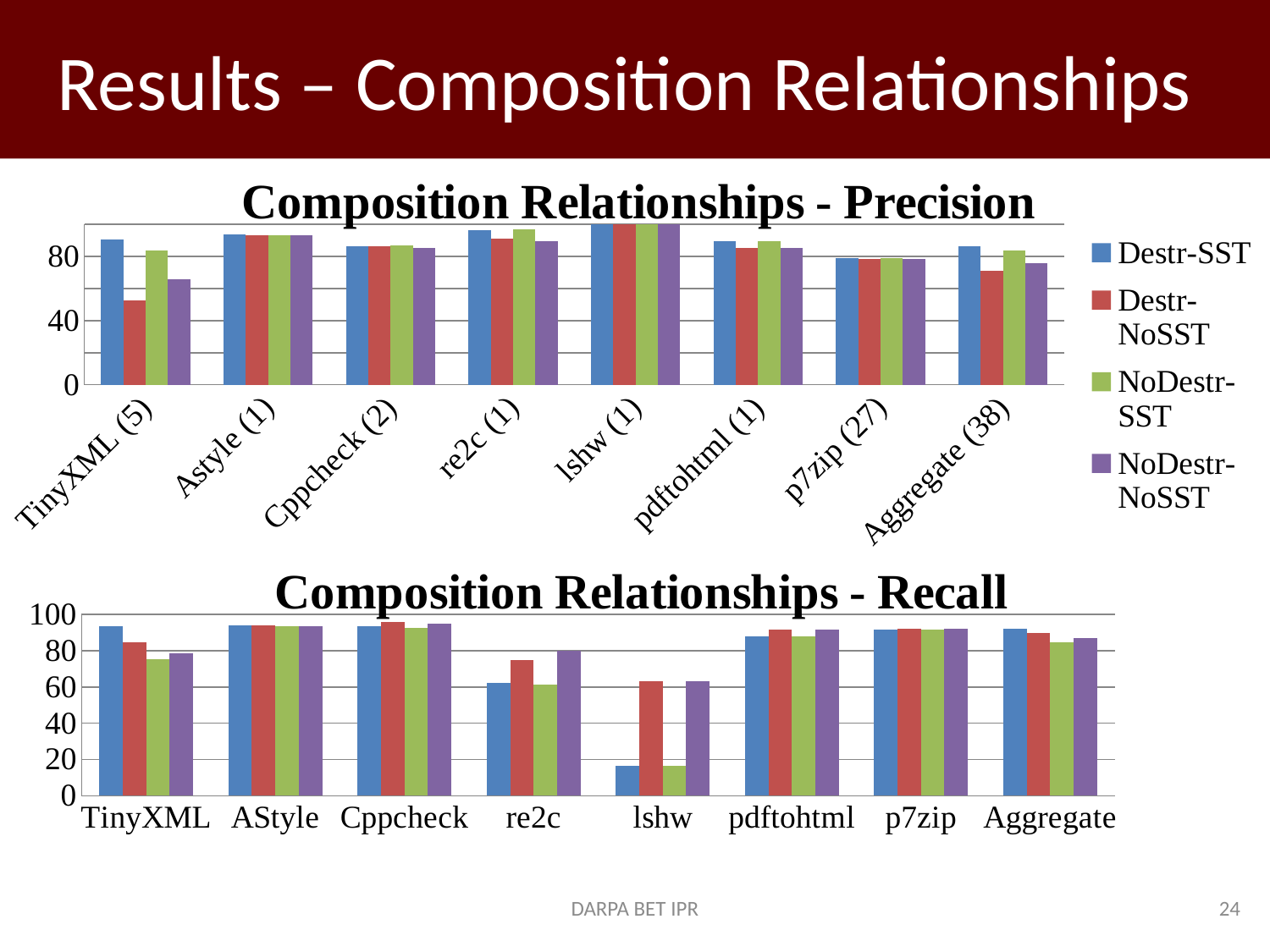
In the "Composition Relationships - Recall" chart, for lshw, which is larger: Destr-SST or Destr-NoSST? Destr-NoSST In the "Composition Relationships - Recall" chart, which category has the lowest Destr-SST value? lshw How many series does the legend of the "Composition Relationships - Precision" chart list? 4 In the "Composition Relationships - Precision" chart, which category has the lowest Destr-NoSST value? TinyXML (5) What kind of chart is the "Composition Relationships - Precision" chart? bar chart In the "Composition Relationships - Precision" chart, for TinyXML (5), which is larger: Destr-SST or Destr-NoSST? Destr-SST In the "Composition Relationships - Precision" chart, is the Destr-NoSST value for TinyXML (5) greater or less than 40? greater In the "Composition Relationships - Recall" chart, is the Destr-SST value for lshw greater or less than 20? less In the "Composition Relationships - Precision" chart, is the Destr-NoSST value for Aggregate (38) greater or less than 80? less What is the title of the bottom chart on the slide? Composition Relationships - Recall How many categories are shown on the x axis of the "Composition Relationships - Recall" chart? 8